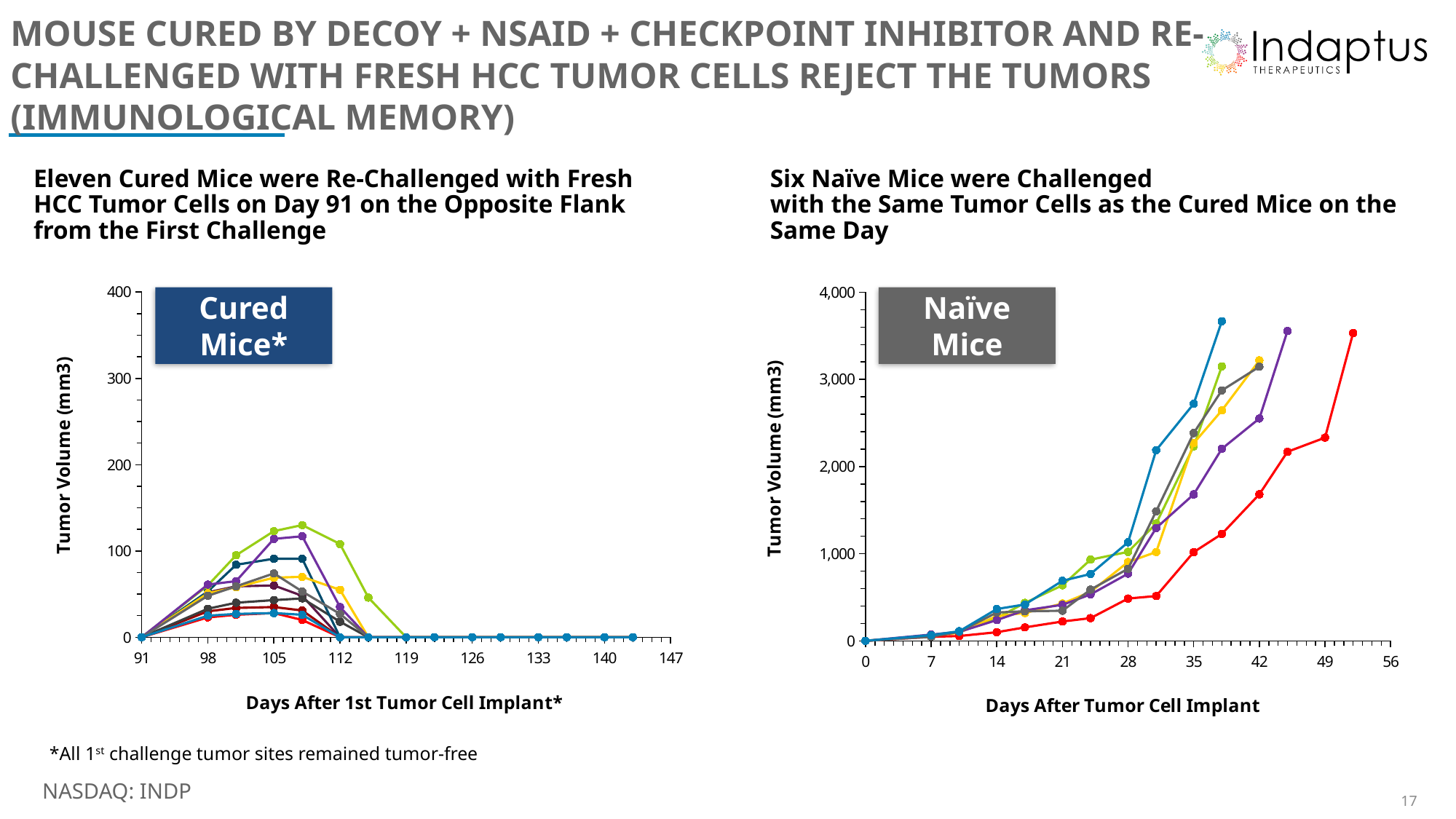
On the Cured Mice chart, what happens to the tumor volumes after about day 119? they stay at 0 What kind of chart is the Cured Mice chart on the left? line chart On the Naïve Mice chart, is the value of the blue line at day 35 greater or less than 2,000? greater On the Naïve Mice chart, is the value of the red line at day 49 greater or less than 2,000? greater On the Naïve Mice chart, is the value of the red line at day 28 greater or less than 1,000? less On the Naïve Mice chart, do the tumor volumes rise or fall as days increase? rise On the Cured Mice chart, what is the title of the x axis? Days After 1st Tumor Cell Implant* On the Naïve Mice chart, what is the highest tick value shown on the y axis? 4,000 On the Cured Mice chart, do the tumor volumes rise or fall between day 108 and day 119? fall What kind of chart is the Naïve Mice chart on the right? line chart